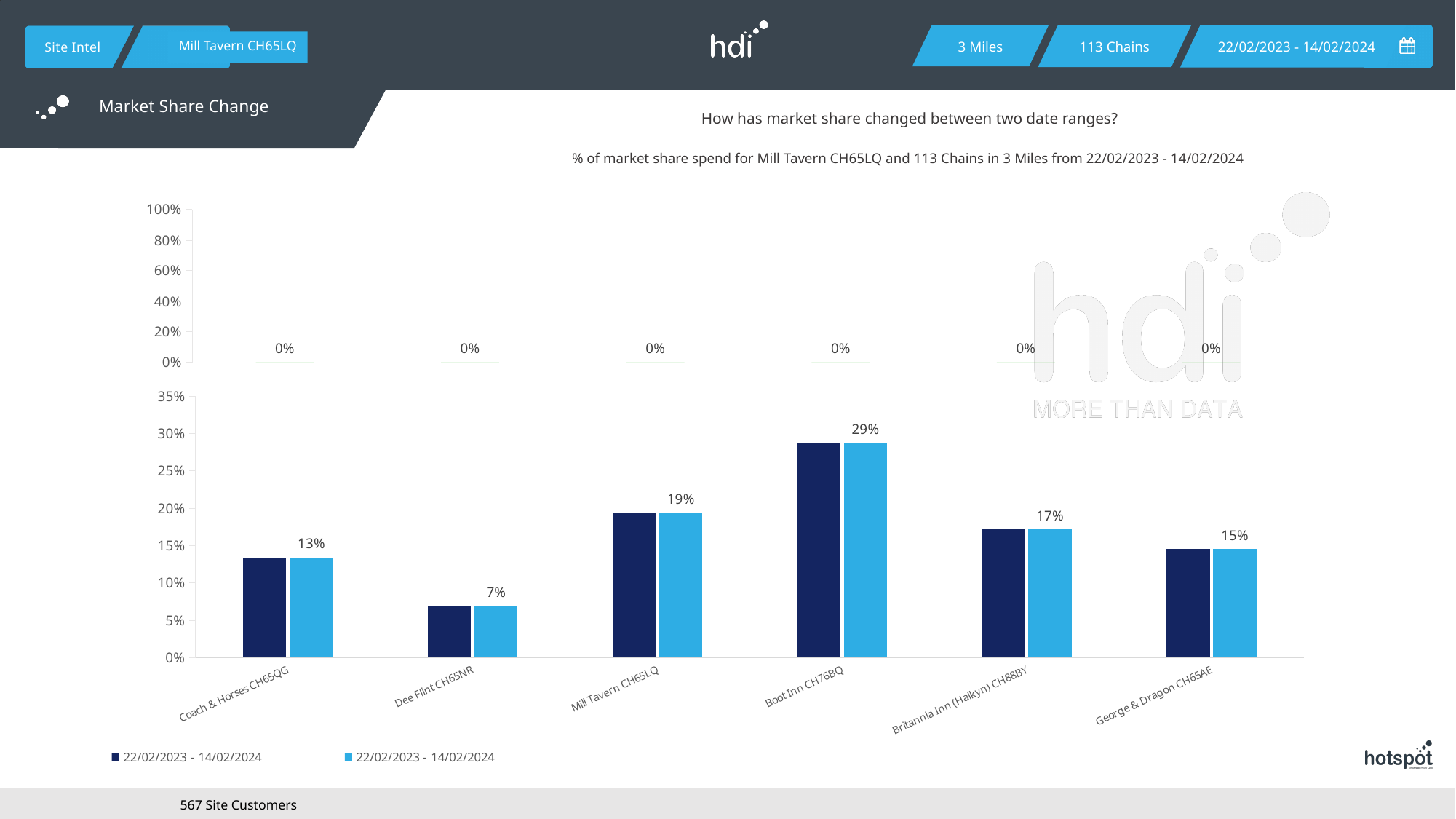
What is the difference between the market share of Boot Inn CH76BQ and Dee Flint CH65NR in the lower bar chart? 22% What kind of chart is used to show the market share values? bar chart In the lower bar chart, which has a larger market share: Mill Tavern CH65LQ or Britannia Inn (Halkyn) CH88BY? Mill Tavern CH65LQ How many categories are shown on the x axis of the lower bar chart? 6 What is the market share value shown for Dee Flint CH65NR in the lower bar chart? 7% What is the market share value shown for Mill Tavern CH65LQ in the lower bar chart? 19% What is the market share value shown for Boot Inn CH76BQ in the lower bar chart? 29% What market share change value is shown for each category in the upper chart? 0% Which category has the lowest market share in the lower bar chart? Dee Flint CH65NR Which category has the highest market share in the lower bar chart? Boot Inn CH76BQ How many series does the legend list? 2 In the lower bar chart, is the value for Coach & Horses CH65QG greater or less than 10%? greater